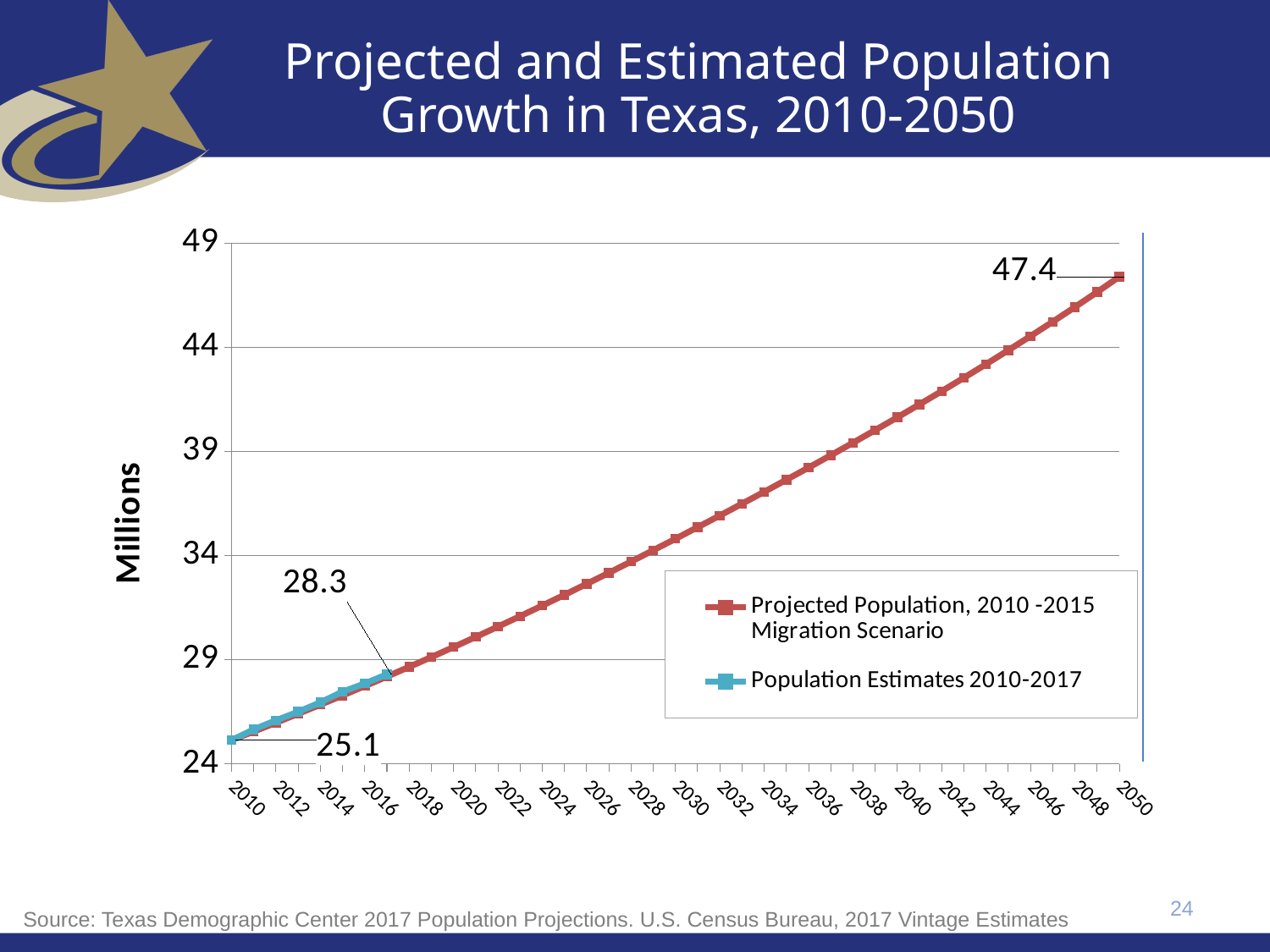
What kind of chart is shown on the slide? line chart What is the projected population of Texas in 2050 according to the chart? 47.4 What is the population value labeled for 2010 on the chart? 25.1 Is the projected population for 2030 greater or less than 34 million? greater What is the difference between the labeled 2050 value (47.4) and the labeled 2010 value (25.1)? 22.3 What value is labeled at the end of the Population Estimates 2010-2017 series? 28.3 Is the projected population for 2020 greater or less than 29 million? greater What is the difference between the labeled 2050 value (47.4) and the labeled 28.3 value? 19.1 What is the title of the vertical axis? Millions Do the population values rise or fall from 2010 to 2050? rise How many series does the legend list? 2 Is the projected population for 2040 greater or less than 39 million? greater